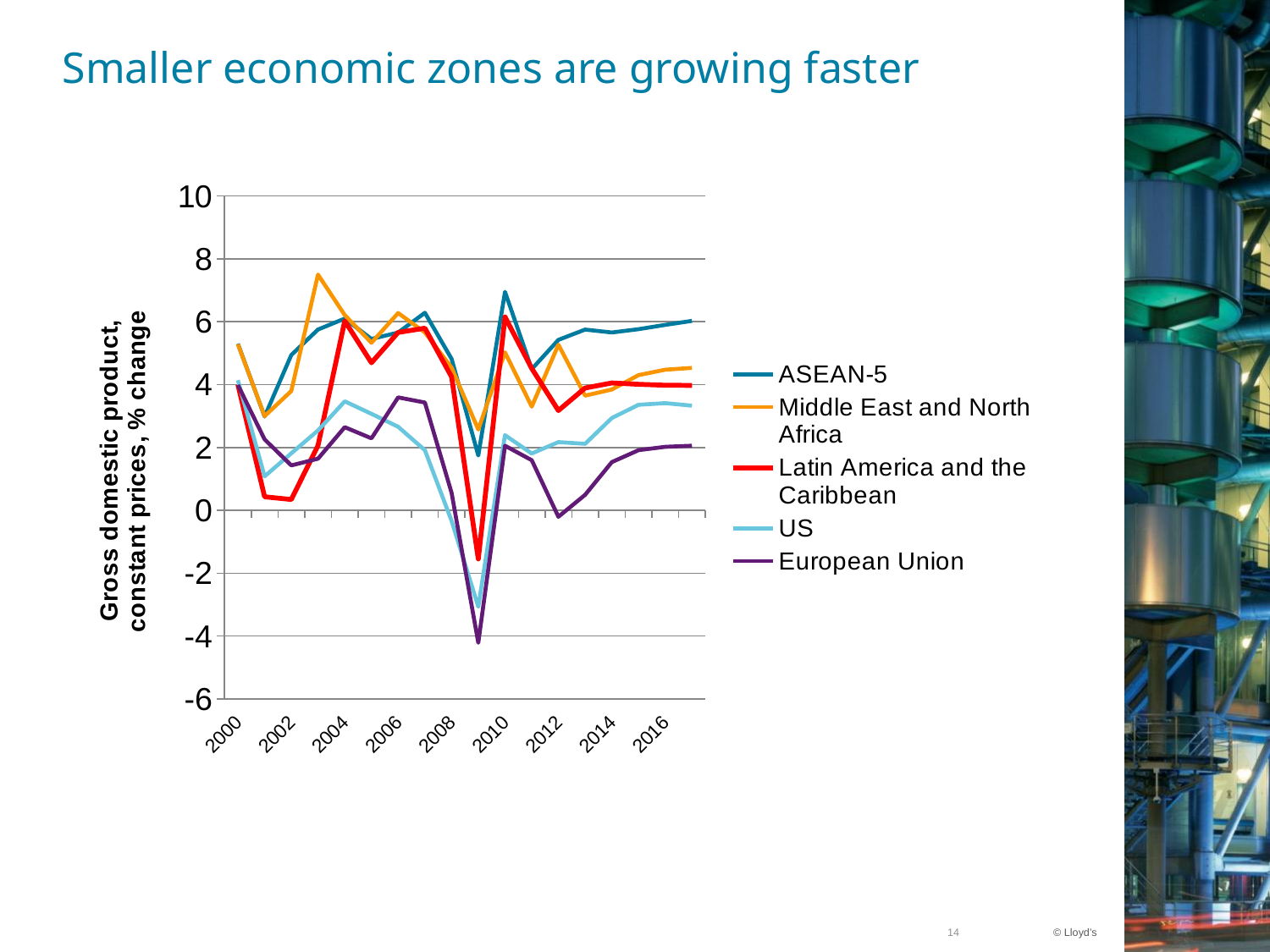
Which series has the highest value in 2016? ASEAN-5 Is the value for US in 2009 greater or less than -2? less Which series has the lowest value in 2009? European Union Does the European Union line rise or fall between 2009 and 2010? rise Which series has the highest value in 2003? Middle East and North Africa In 2016, which is larger: the value for ASEAN-5 or the value for European Union? ASEAN-5 How many year labels are shown along the x axis? 9 What kind of chart is shown on the slide? line chart What is the label on the y axis of the chart? Gross domestic product, constant prices, % change Is the value for Latin America and the Caribbean in 2002 greater or less than 2? less How many series does the legend list? 5 Is the value for Middle East and North Africa in 2003 greater or less than 6? greater